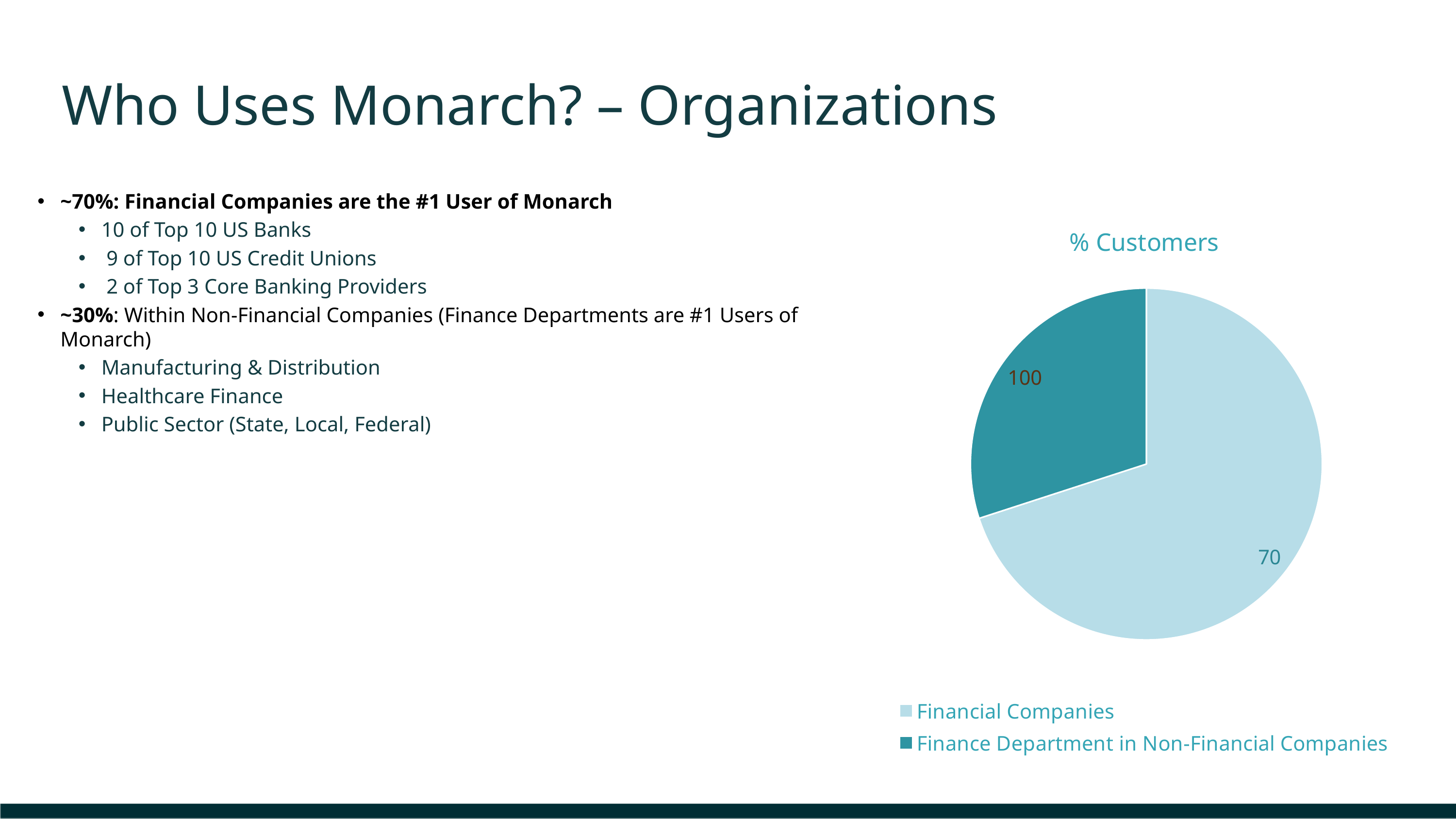
What is the title of the chart on the slide? % Customers What colour is the Financial Companies slice in the pie chart? light blue What data label is printed on the Finance Department in Non-Financial Companies slice of the pie chart? 100 How many entries does the legend of the pie chart list? 2 How many slices does the pie chart have? 2 What kind of chart is shown on the slide? pie chart Which slice occupies the larger portion of the pie chart, Financial Companies or Finance Department in Non-Financial Companies? Financial Companies What data label is printed on the Financial Companies slice of the pie chart? 70